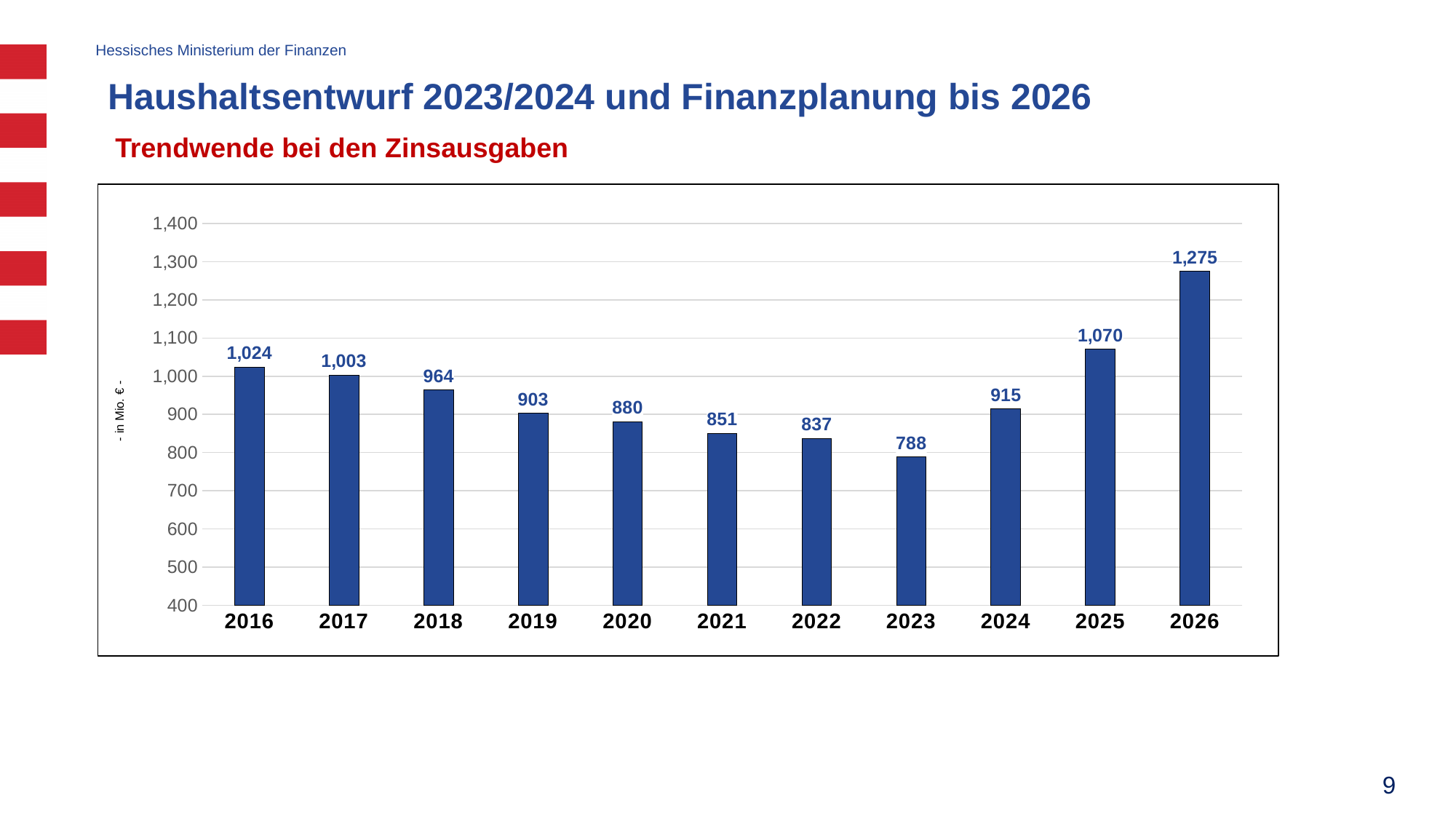
What is the difference between the values for 2026 and 2025? 205 Which year has the highest value? 2026 What kind of chart is shown on the slide? bar chart What is the value for 2026? 1,275 Which is larger, the value for 2019 or the value for 2024? 2024 Which year has the lowest value? 2023 How many years are shown on the x axis? 11 Do the values rise or fall from 2016 to 2023? fall What is the difference between the values for 2016 and 2023? 236 What is the value for 2016? 1,024 Is the value for 2022 greater or less than 900? less What is the value for 2023? 788